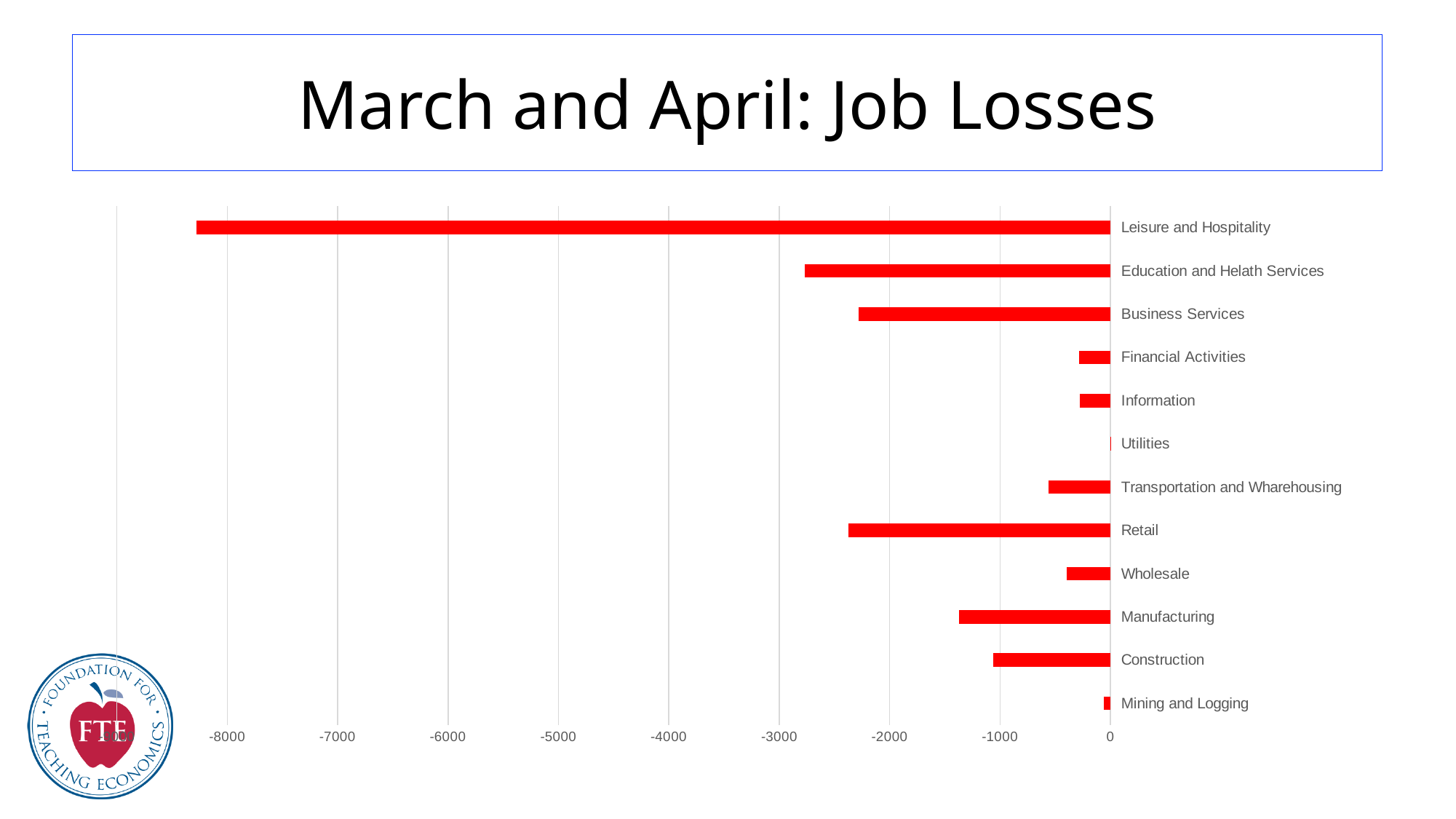
Which category shows a larger job loss, Education and Helath Services or Retail? Education and Helath Services Which category has the shortest bar, i.e. the smallest job loss? Utilities Which category shows a larger job loss, Manufacturing or Construction? Manufacturing Is the value for Manufacturing greater or less than -1000? less Does the bar for Leisure and Hospitality extend past the -8000 gridline? yes What kind of chart is shown on the slide? bar chart How many categories (industries) are plotted in the chart? 12 What is the title of the slide? March and April: Job Losses What colour are the bars in the chart? red Is the value for Wholesale greater or less than -1000? greater Which category has the longest bar, i.e. the largest job loss? Leisure and Hospitality